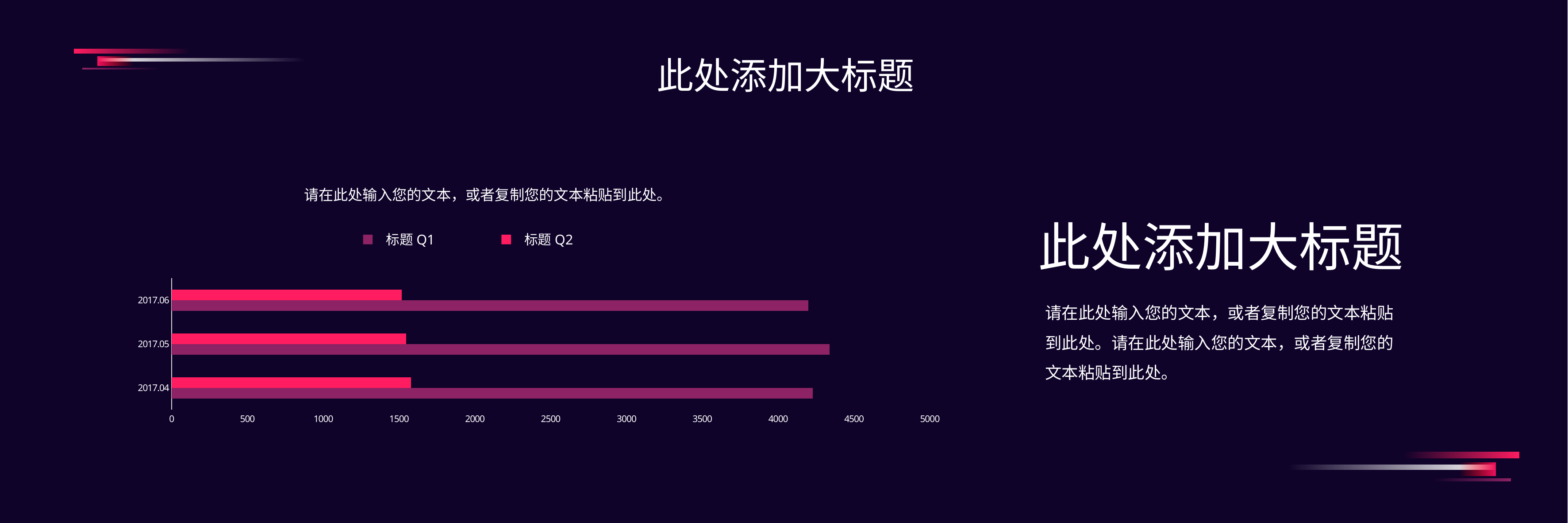
Is the 标题 Q1 value for 2017.04 greater or less than 4000? greater For 2017.04, which series has the larger value, 标题 Q1 or 标题 Q2? 标题 Q1 What are the two series names shown in the chart legend? 标题 Q1 and 标题 Q2 Is the 标题 Q1 value for 2017.06 greater or less than 4500? less How many categories are plotted on the chart? 3 Is the 标题 Q1 value for 2017.05 greater or less than 4000? greater What is the highest value shown on the chart's horizontal axis? 5000 How many series does the chart legend list? 2 For the 标题 Q1 series, which is larger, the value for 2017.05 or the value for 2017.06? 2017.05 What kind of chart is shown on the slide? bar chart